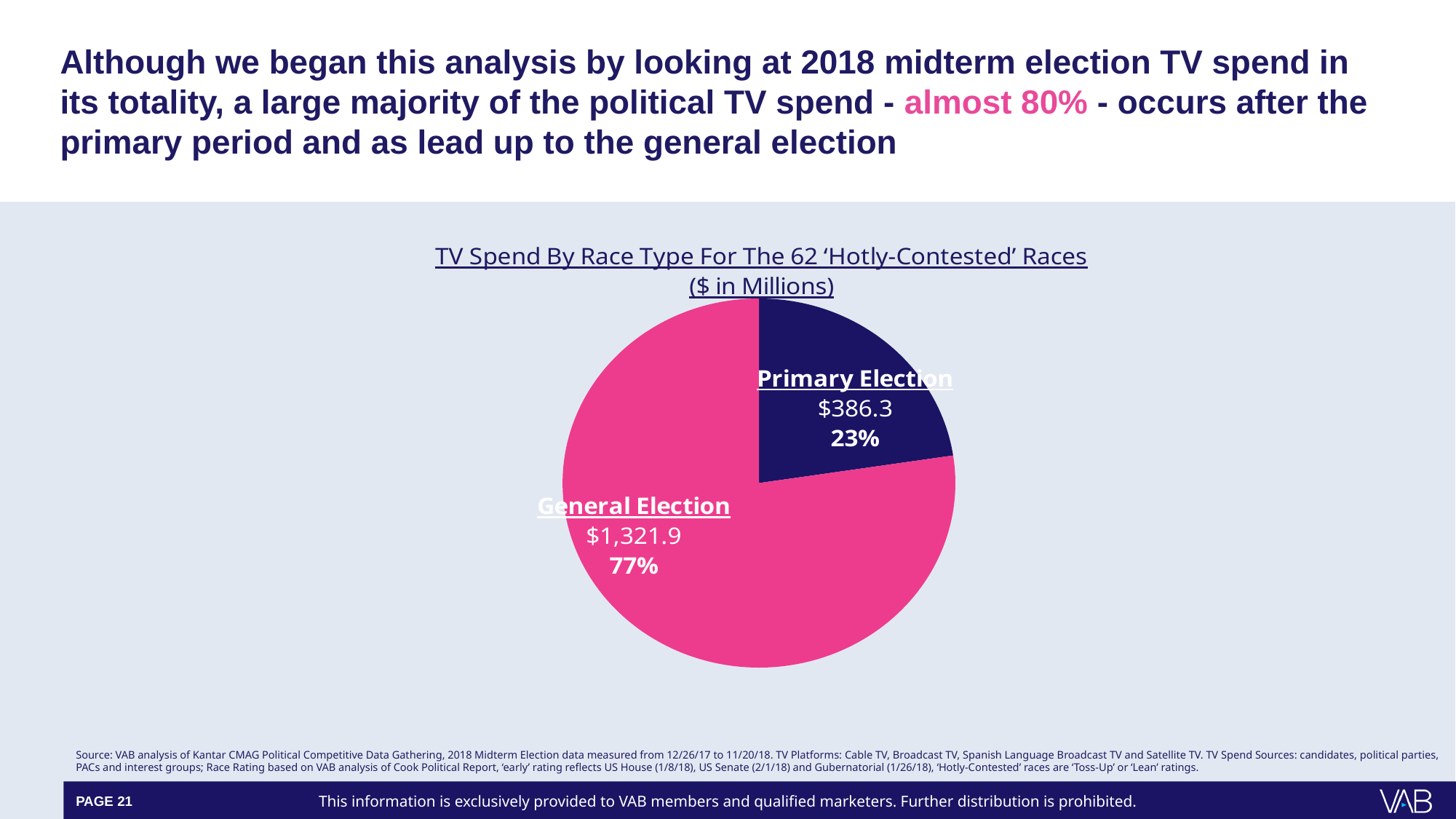
What is the title of the pie chart? TV Spend By Race Type For The 62 'Hotly-Contested' Races ($ in Millions) What kind of chart is shown on the slide? Pie chart What is the TV spend for the General Election slice? $1,321.9 What share of the pie does the Primary Election slice represent? 23% How many slices does the pie chart have? 2 Which race type has the highest TV spend? General Election What colour is the General Election slice? Pink What share of the pie does the General Election slice represent? 77% Which is larger, the TV spend for the General Election or the Primary Election? General Election What is the difference in TV spend between the General Election and the Primary Election? $935.6 Which race type has the lowest TV spend? Primary Election What is the TV spend for the Primary Election slice? $386.3